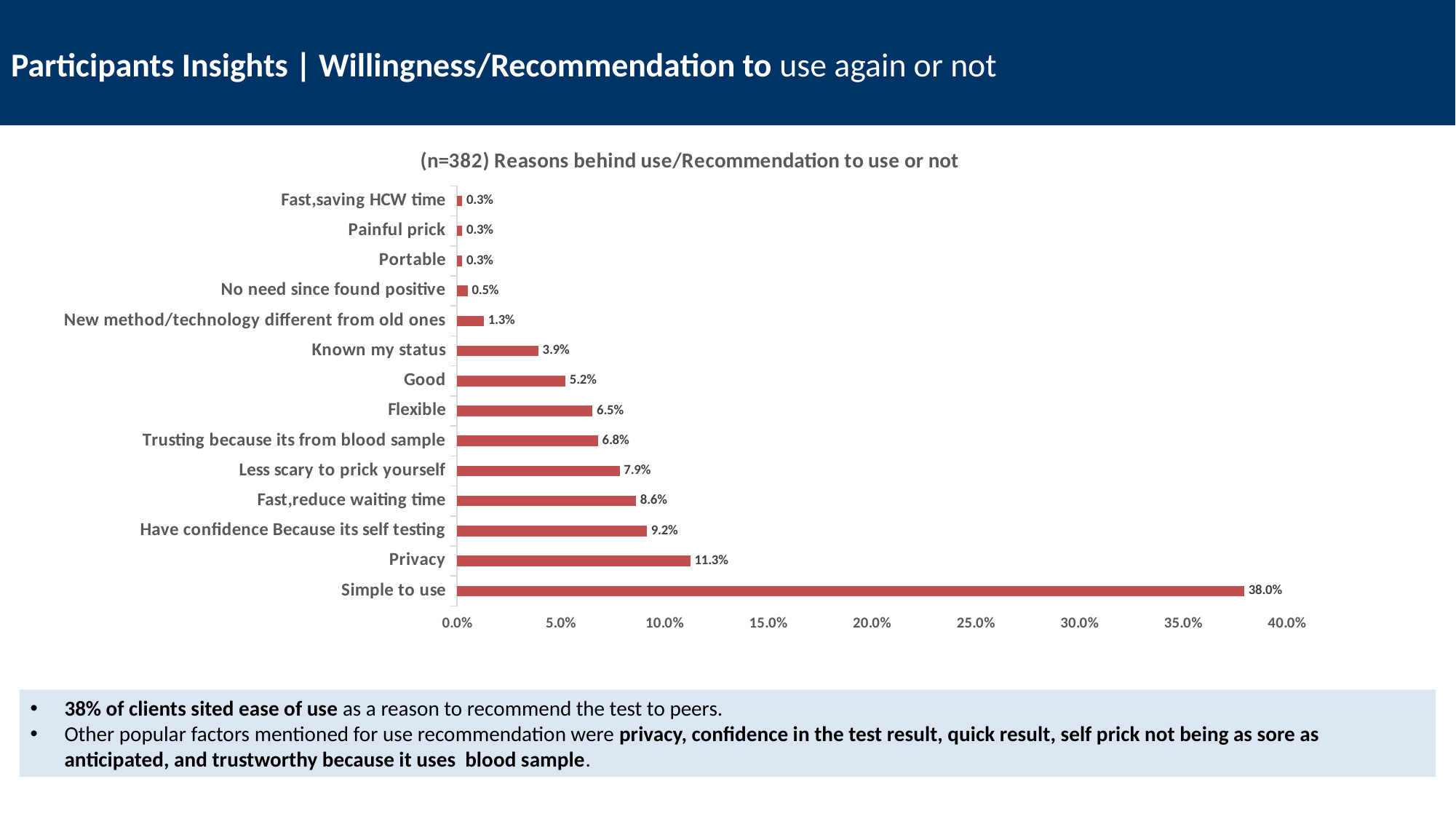
What is the value for Privacy? 11.3% What is the difference between Simple to use and Privacy? 26.7% Which category has the highest value? Simple to use Which is larger, Have confidence Because its self testing or Trusting because its from blood sample? Have confidence Because its self testing How many categories have a value of 0.3%? 3 What is the difference between Fast,reduce waiting time and Flexible? 2.1% Is the value for Simple to use greater or less than 35.0%? greater What is the value for Less scary to prick yourself? 7.9% How many categories are shown in the chart? 14 What is the value for Known my status? 3.9% What kind of chart is shown on the slide? Bar chart What is the title of the chart? (n=382) Reasons behind use/Recommendation to use or not